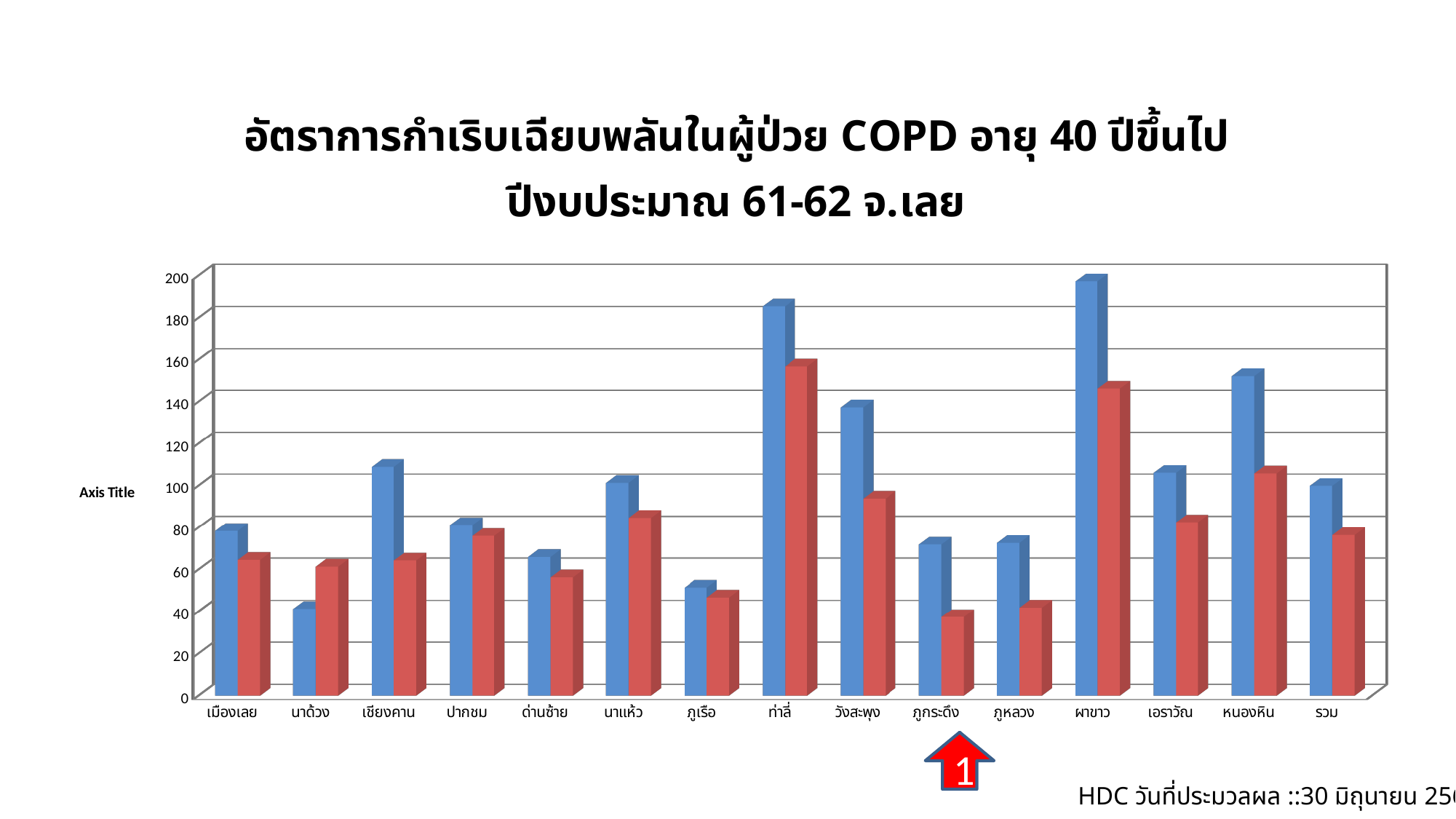
Is the red bar for ภูกระดึง greater or less than 60? less Is the blue bar for ท่าลี่ greater or less than 160? greater Which category does the red arrow labelled 1 below the chart point to? ภูกระดึง Is the blue bar for นาด้วง greater or less than 60? less What kind of chart is shown on the slide? bar chart Which category has the lowest blue bar? นาด้วง How many categories are shown along the x axis of the chart? 15 Which category has the highest red bar? ท่าลี่ For ท่าลี่, which bar is taller, the blue one or the red one? blue For นาด้วง, which bar is taller, the blue one or the red one? red Which category has the highest blue bar? ผาขาว